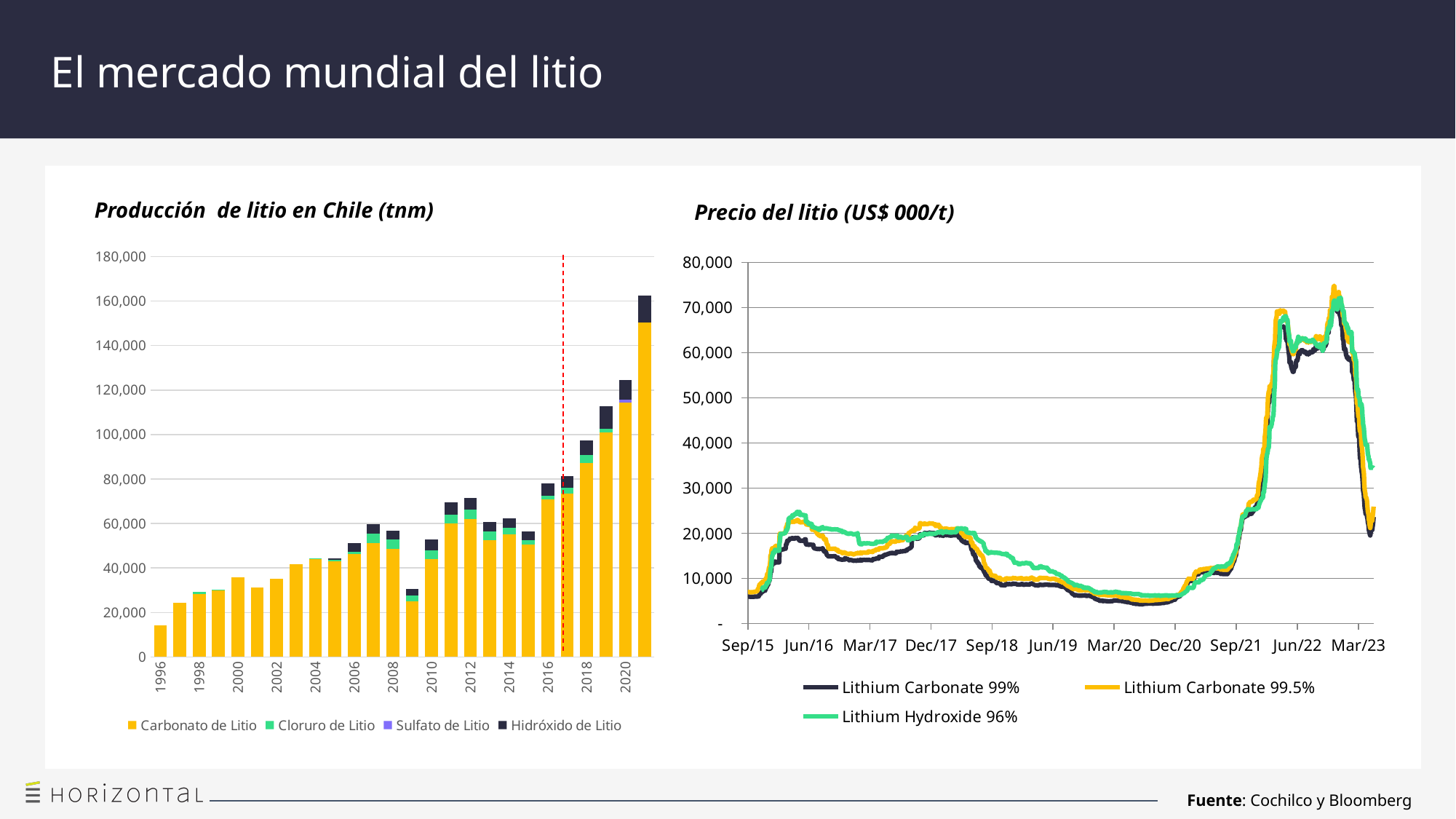
In 'Producción de litio en Chile (tnm)', is the total for 2009 greater or less than 40,000? less In 'Precio del litio (US$ 000/t)', is the peak value of Lithium Carbonate 99.5% greater or less than 70,000? greater How many series does the legend of 'Producción de litio en Chile (tnm)' list? 4 What kind of chart is 'Producción de litio en Chile (tnm)'? Stacked bar chart In 'Producción de litio en Chile (tnm)', which year has the highest total production? 2021 In 'Producción de litio en Chile (tnm)', which year has the lowest total production? 1996 In 'Producción de litio en Chile (tnm)', which year has the larger total production, 2020 or 2016? 2020 What kind of chart is 'Precio del litio (US$ 000/t)'? Line chart In 'Precio del litio (US$ 000/t)', which series is drawn in black? Lithium Carbonate 99% How many series does the legend of 'Precio del litio (US$ 000/t)' list? 3 In 'Producción de litio en Chile (tnm)', is the total for 1996 greater or less than 20,000? less